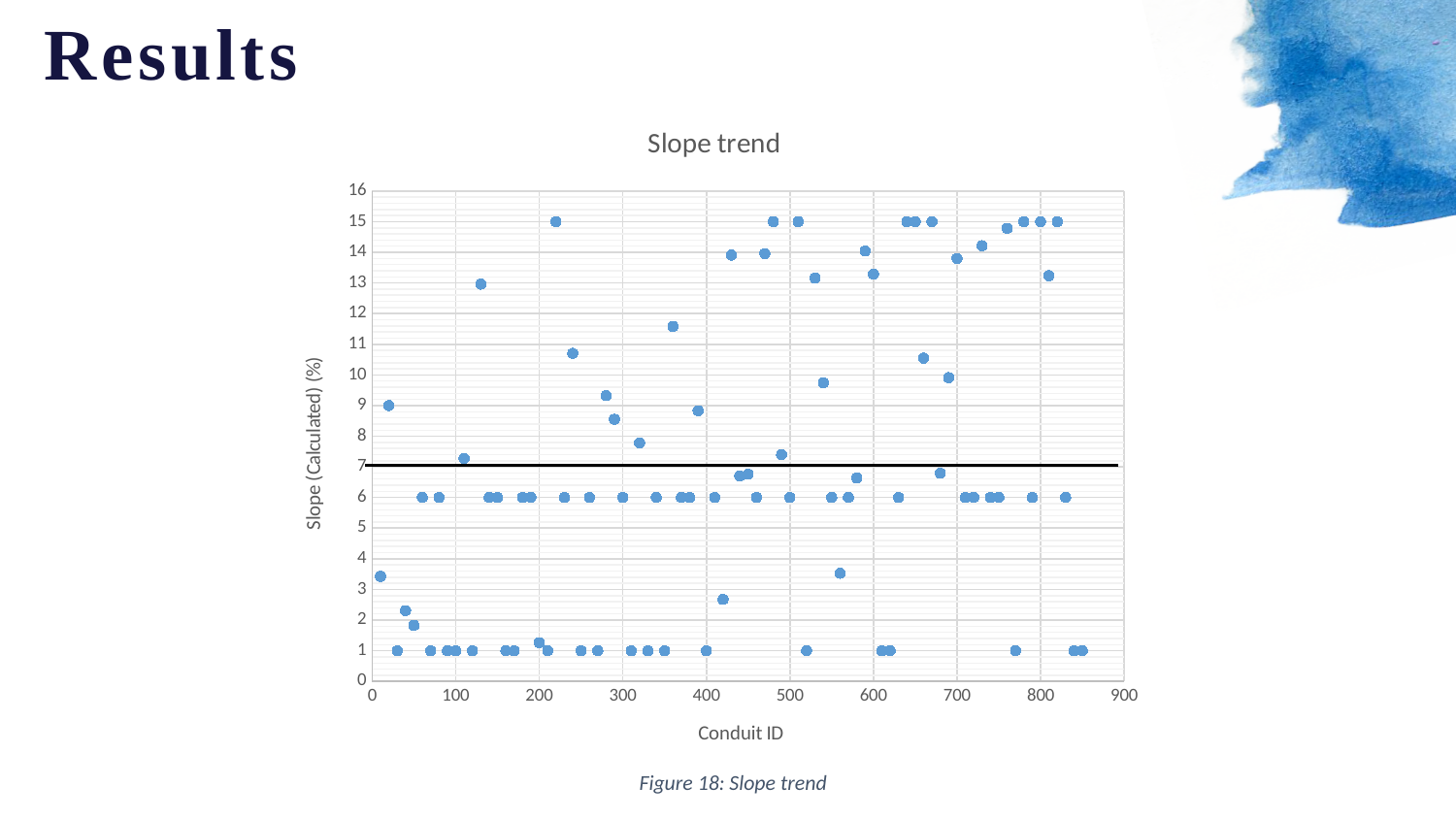
At what y-axis value is the horizontal black line drawn across the chart? 7 Is the highest plotted slope value greater or less than 14? greater Is the plotted slope value for the conduit with ID near 360 greater or less than 10? greater What is the highest value shown on the y axis of the chart? 16 What kind of chart is shown on the slide? scatter chart What is the label of the x axis of the chart? Conduit ID What is the title of the chart? Slope trend